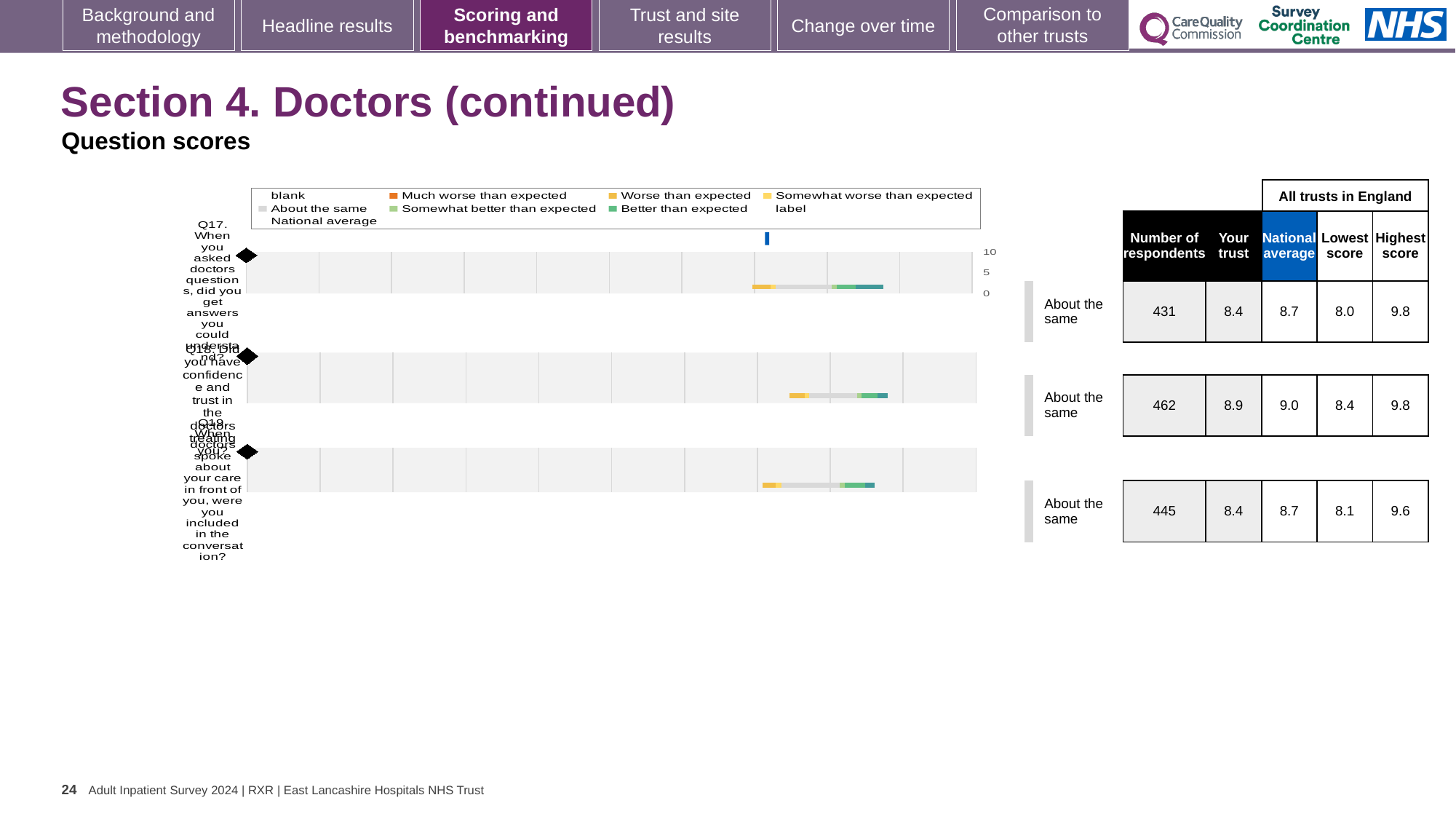
Which legend entry is shown in orange? Much worse than expected How many questions (rows) are plotted in the chart? 3 Which of the three questions has the lowest 'Lowest score' value? Q17 What is the national average score for Q18 (Did you have confidence and trust in the doctors treating you?)? 9.0 What is the 'Your trust' score for Q17 (When you asked doctors questions, did you get answers you could understand?)? 8.4 Which question has more respondents, Q17 or Q18? Q18 What is the difference between the national average and the 'Your trust' score for Q18? 0.1 What is the highest score across all trusts in England for Q19? 9.6 Which of the three questions has the highest 'Your trust' score? Q18 How many respondents answered Q19 (When doctors spoke about your care in front of you, were you included in the conversation?)? 445 What kind of chart is used to show the question scores on this slide? bar chart